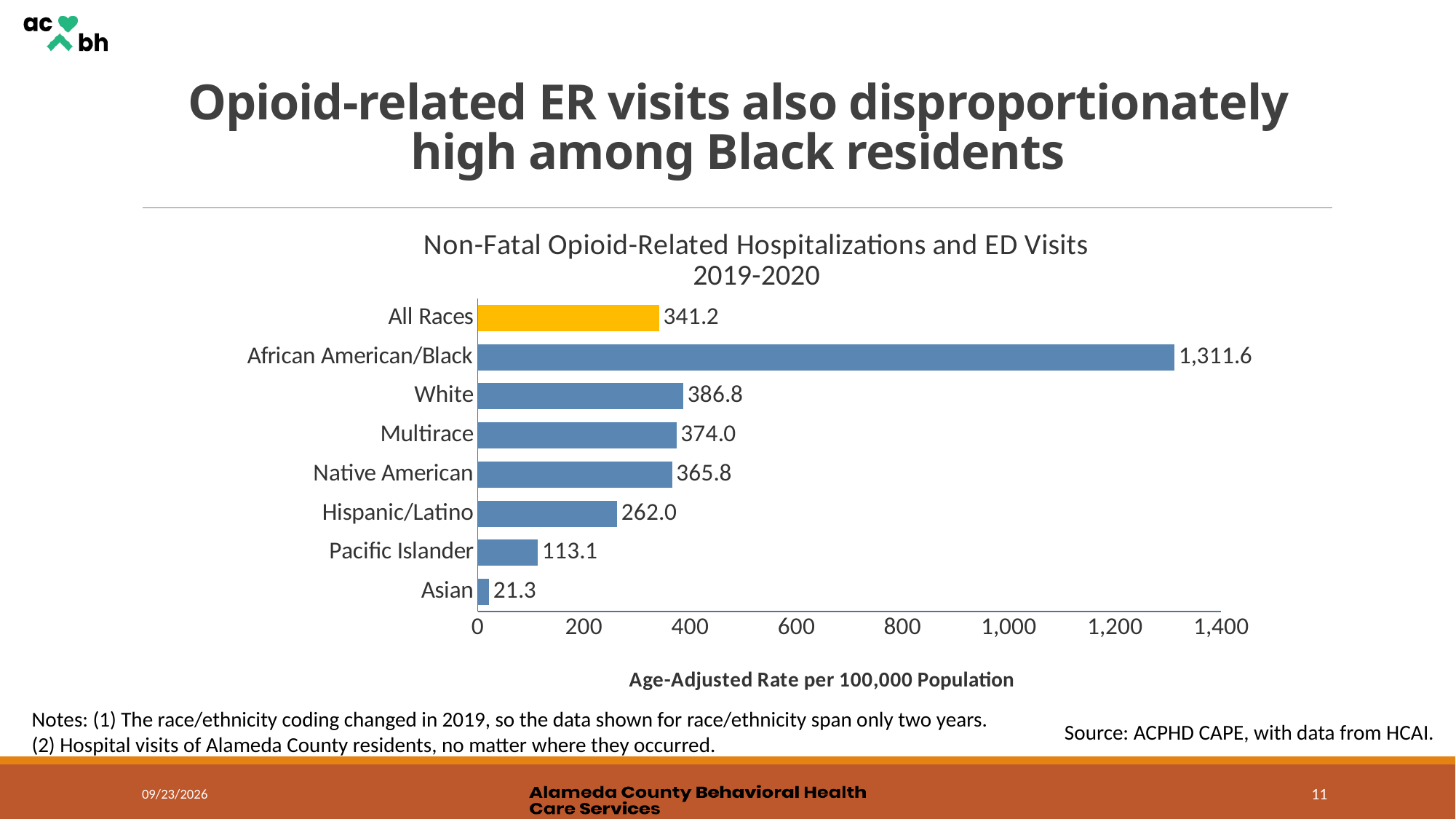
Is the value for Native American greater or less than 400? less What is the difference between the African American/Black rate and the All Races rate? 970.4 Which category has the highest rate? African American/Black What is the age-adjusted rate for All Races? 341.2 What is the title of the chart? Non-Fatal Opioid-Related Hospitalizations and ED Visits 2019-2020 Which is larger, the rate for Multirace or the rate for Hispanic/Latino? Multirace How many categories are shown on the chart? 8 What is the value shown for Pacific Islander? 113.1 What kind of chart is shown on the slide? bar chart What is the age-adjusted rate for African American/Black residents? 1,311.6 What is the difference between the White rate and the Hispanic/Latino rate? 124.8 Which category has the lowest rate? Asian